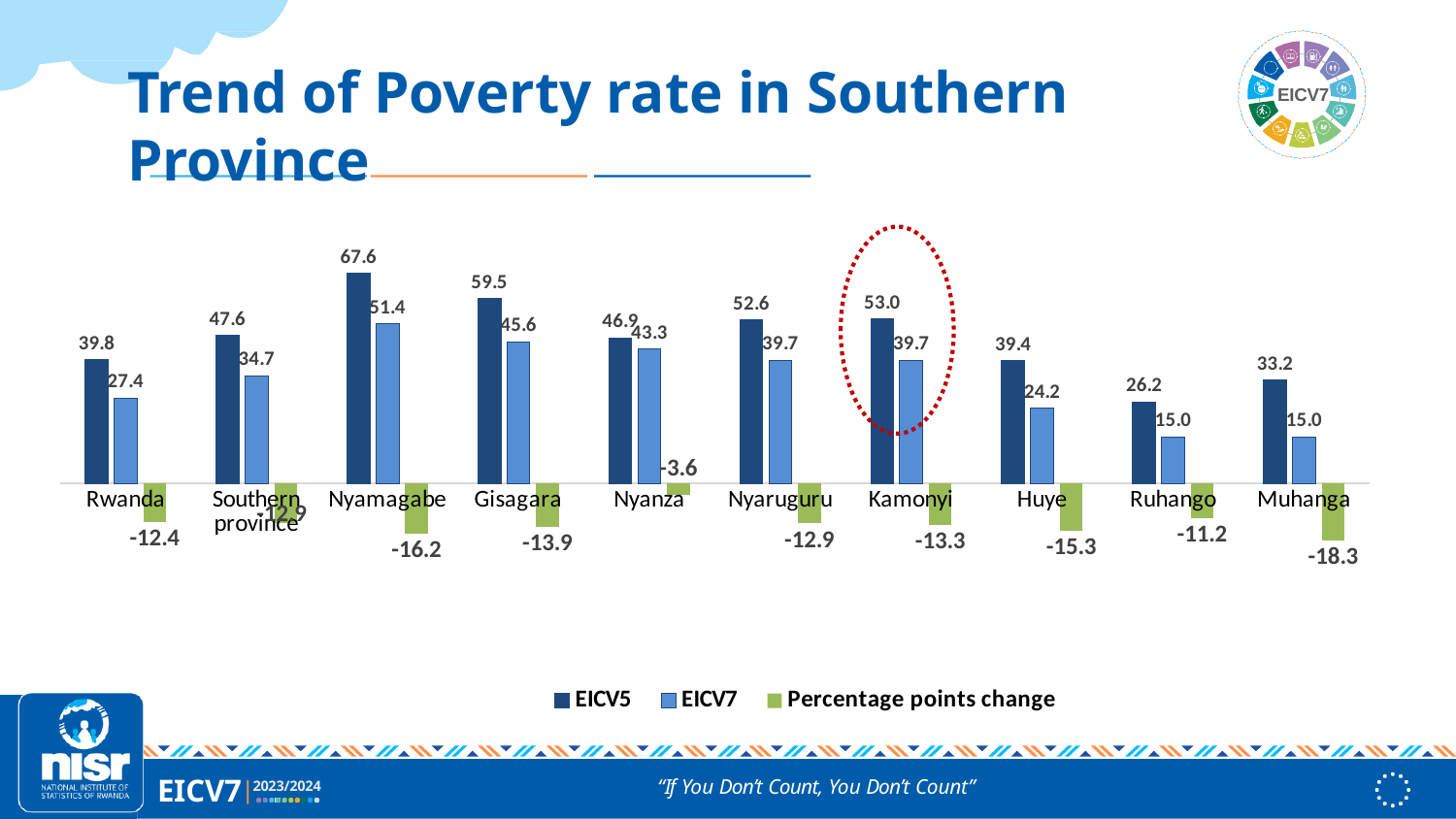
Which is larger, the EICV7 poverty rate for Nyanza or for Nyaruguru? Nyanza What is the difference between the EICV5 and EICV7 poverty rates for Gisagara? 13.9 What is the EICV7 poverty rate for Kamonyi? 39.7 Which category has the lowest EICV5 poverty rate? Ruhango What kind of chart is shown on the slide? Bar chart What is the percentage points change for Muhanga? -18.3 Which category has the highest EICV5 poverty rate? Nyamagabe What is the EICV5 poverty rate for Nyamagabe? 67.6 How many series does the legend list? 3 What is the EICV7 poverty rate for Huye? 24.2 How many categories are shown on the x axis? 10 Which category has the smallest percentage points change in absolute terms? Nyanza